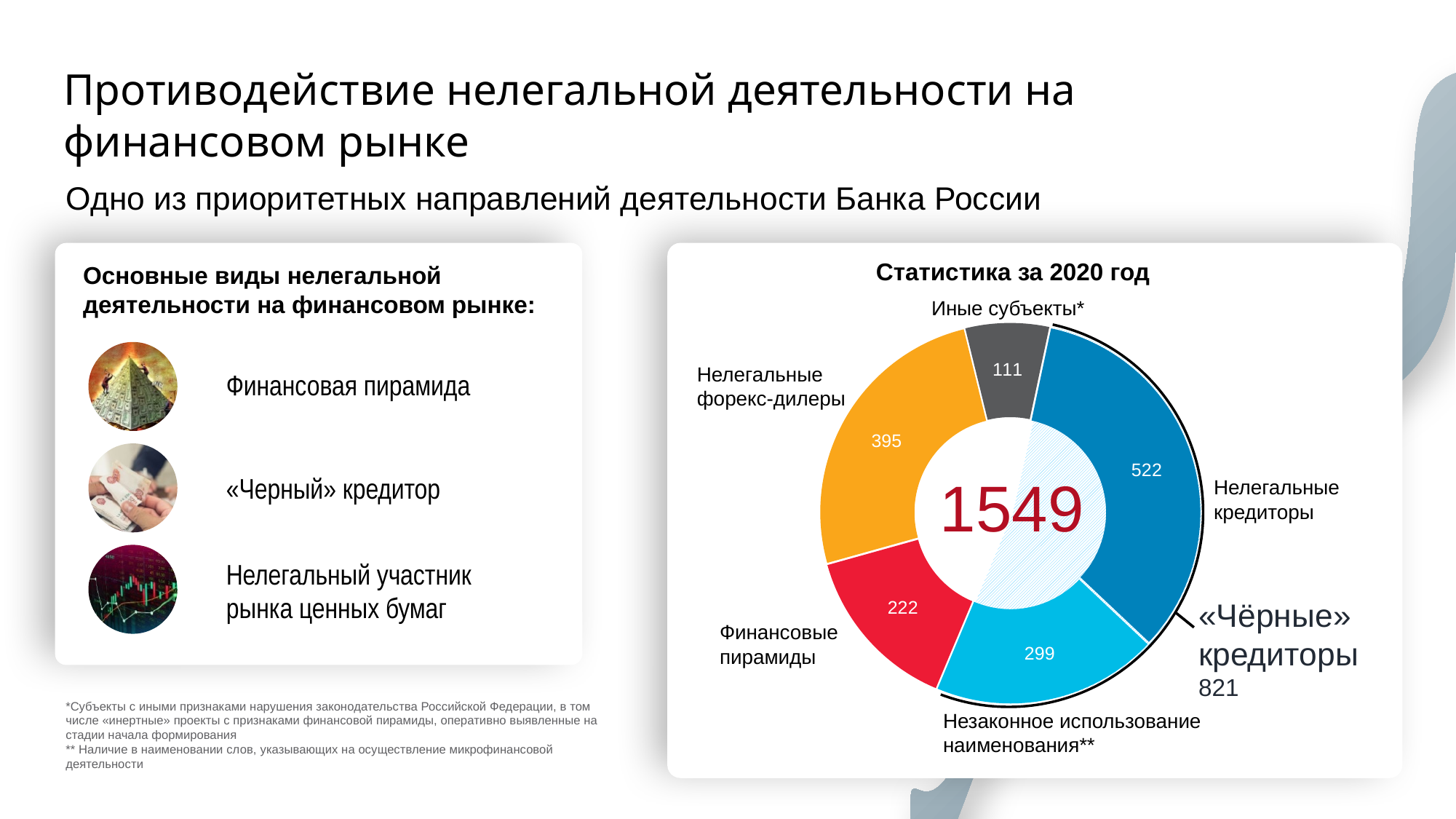
Какое значение указано для сегмента «Незаконное использование наименования**»? 299 Какой сегмент диаграммы имеет наименьшее значение? Иные субъекты* Что больше: «Нелегальные форекс-дилеры» или «Незаконное использование наименования**»? Нелегальные форекс-дилеры Какое значение указано для сегмента «Иные субъекты*»? 111 Какое значение указано для сегмента «Нелегальные форекс-дилеры»? 395 Какое значение указано для сегмента «Финансовые пирамиды»? 222 Какой тип диаграммы показан на слайде? Кольцевая (круговая) диаграмма Какое значение указано для сегмента «Нелегальные кредиторы» на диаграмме «Статистика за 2020 год»? 522 Какой сегмент диаграммы имеет наибольшее значение? Нелегальные кредиторы Какое общее число указано в центре диаграммы? 1549 На сколько значение «Нелегальные кредиторы» больше значения «Финансовые пирамиды»? 300 Сколько сегментов на диаграмме? 5